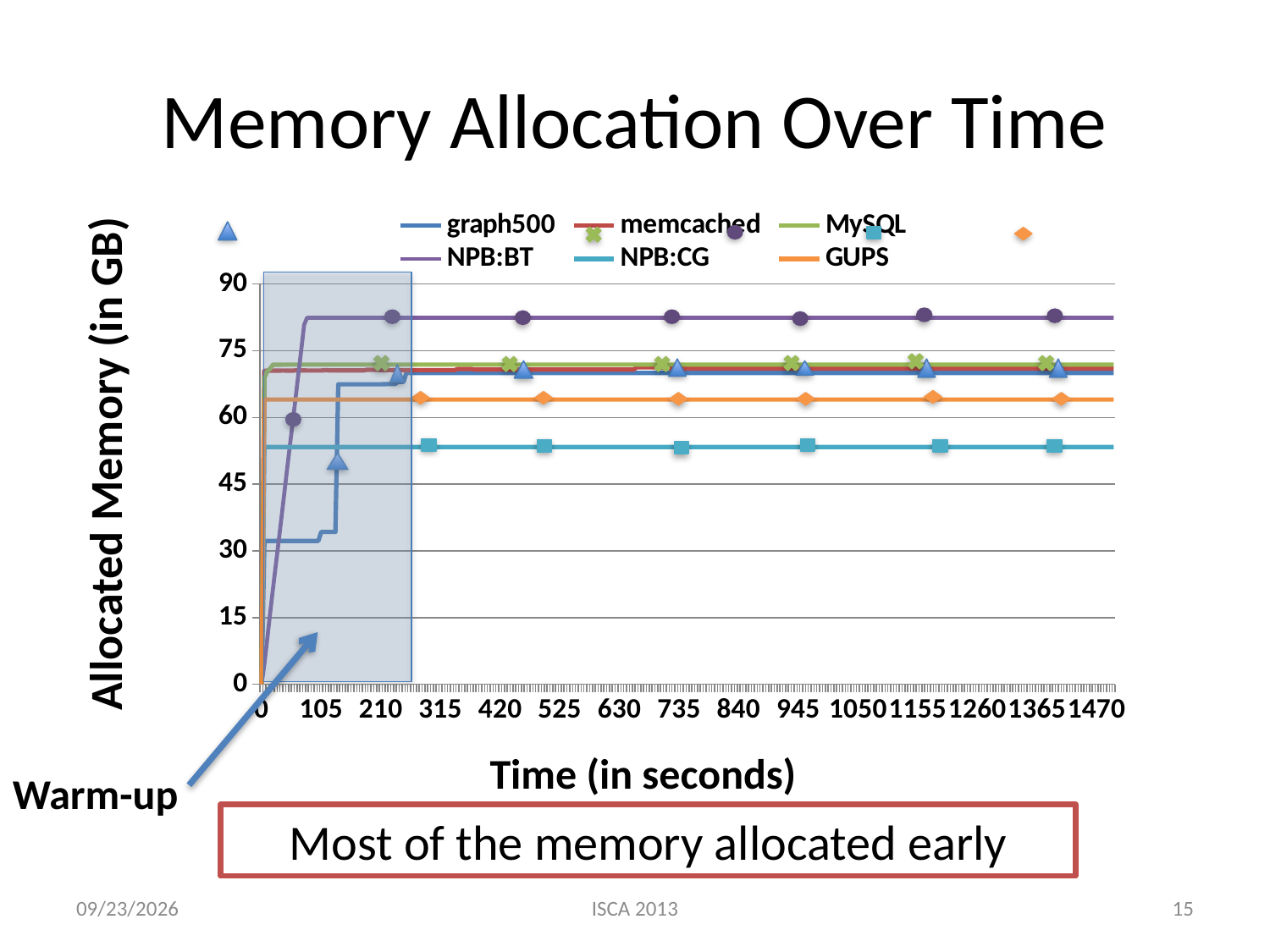
How many series does the legend list? 6 How does the allocated memory for graph500 change over time? rises in steps early, then stays flat Which series has a higher steady-state allocated memory, NPB:BT or GUPS? NPB:BT Which series has the lowest steady-state allocated memory? NPB:CG What is the title of the chart? Memory Allocation Over Time What kind of chart is shown on the slide? line chart What is the label of the y axis? Allocated Memory (in GB) Is the steady-state allocated memory for GUPS greater or less than 60 GB? greater Which series reaches the highest allocated memory? NPB:BT Is the steady-state allocated memory for NPB:BT greater or less than 75 GB? greater Is the steady-state allocated memory for NPB:CG greater or less than 60 GB? less